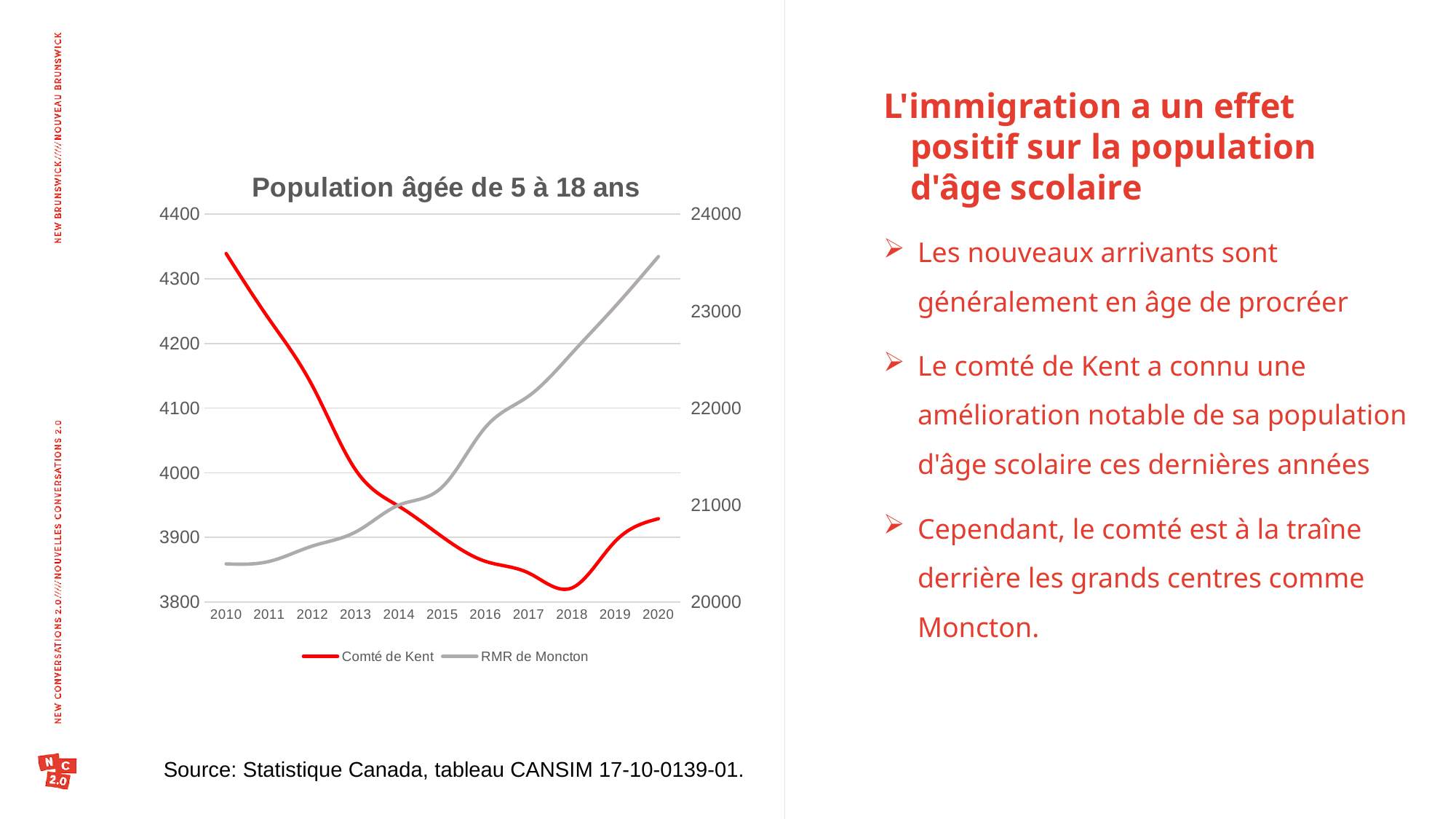
Is the RMR de Moncton value for 2020 greater or less than 23000? greater How many years are plotted along the x axis? 11 Does the RMR de Moncton series rise or fall from 2010 to 2020? rise What kind of chart is shown on the slide? line chart In which year is the RMR de Moncton value highest? 2020 What is the title of the chart? Population âgée de 5 à 18 ans Which series is drawn in red? Comté de Kent Does the Comté de Kent series rise or fall from 2010 to 2018? fall In which year is the Comté de Kent value highest? 2010 Is the Comté de Kent value for 2010 greater or less than 4300? greater In which year is the Comté de Kent value lowest? 2018 How many series does the legend list? 2